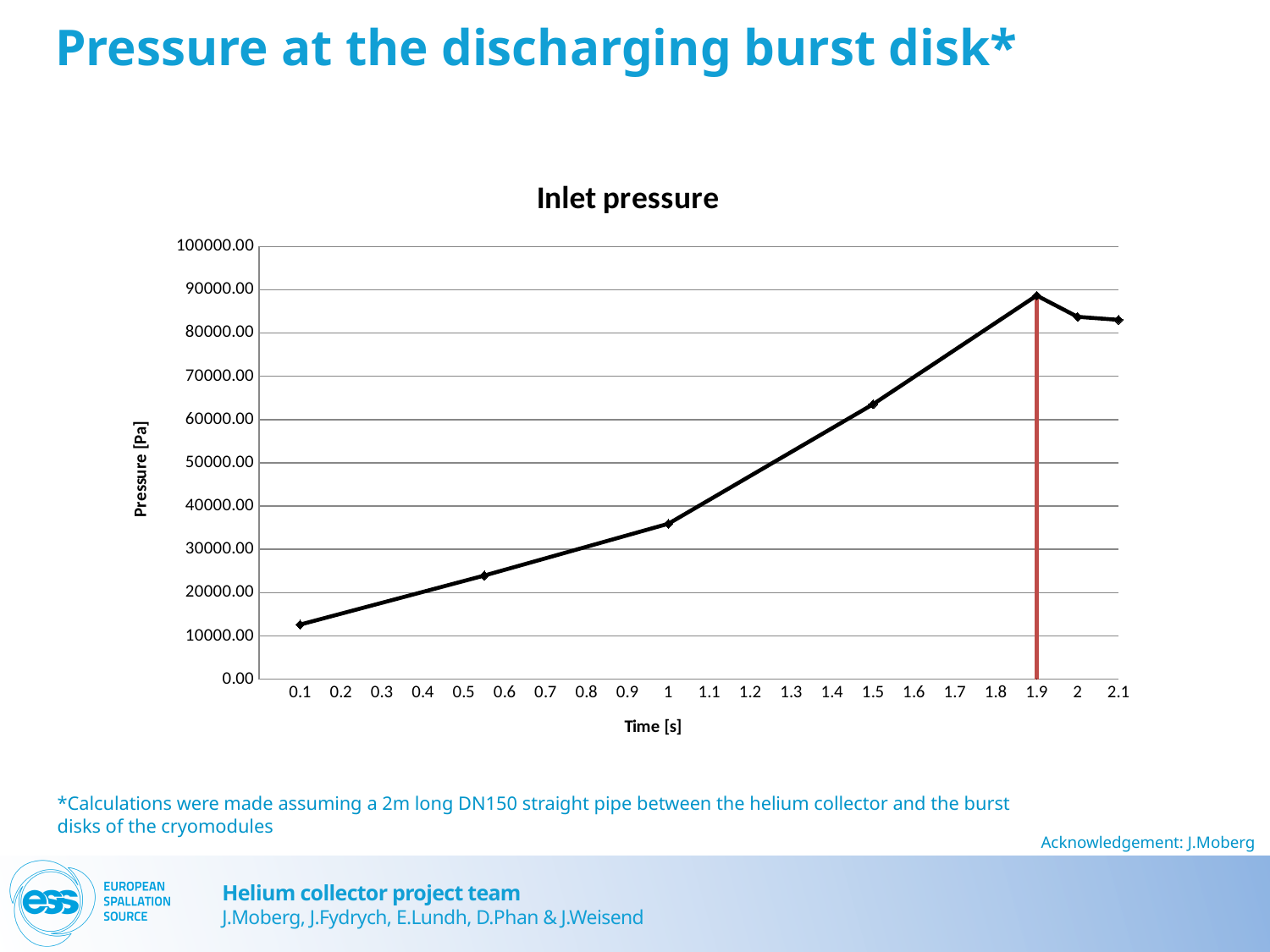
What kind of chart is shown on the slide? line chart Is the pressure at time 1 greater or less than 40000.00? less At which time does the inlet pressure reach its highest value? 1.9 Which has the higher pressure, time 1.9 or time 2.1? 1.9 What is the title of the chart? Inlet pressure Is the pressure at time 1.5 greater or less than 60000.00? greater What is the label of the vertical axis? Pressure [Pa] How many data points are plotted on the line? 7 Is the pressure at time 2.1 greater or less than 80000.00? greater Does the pressure rise or fall between time 0.1 and time 1.9? rise At which time is the inlet pressure lowest? 0.1